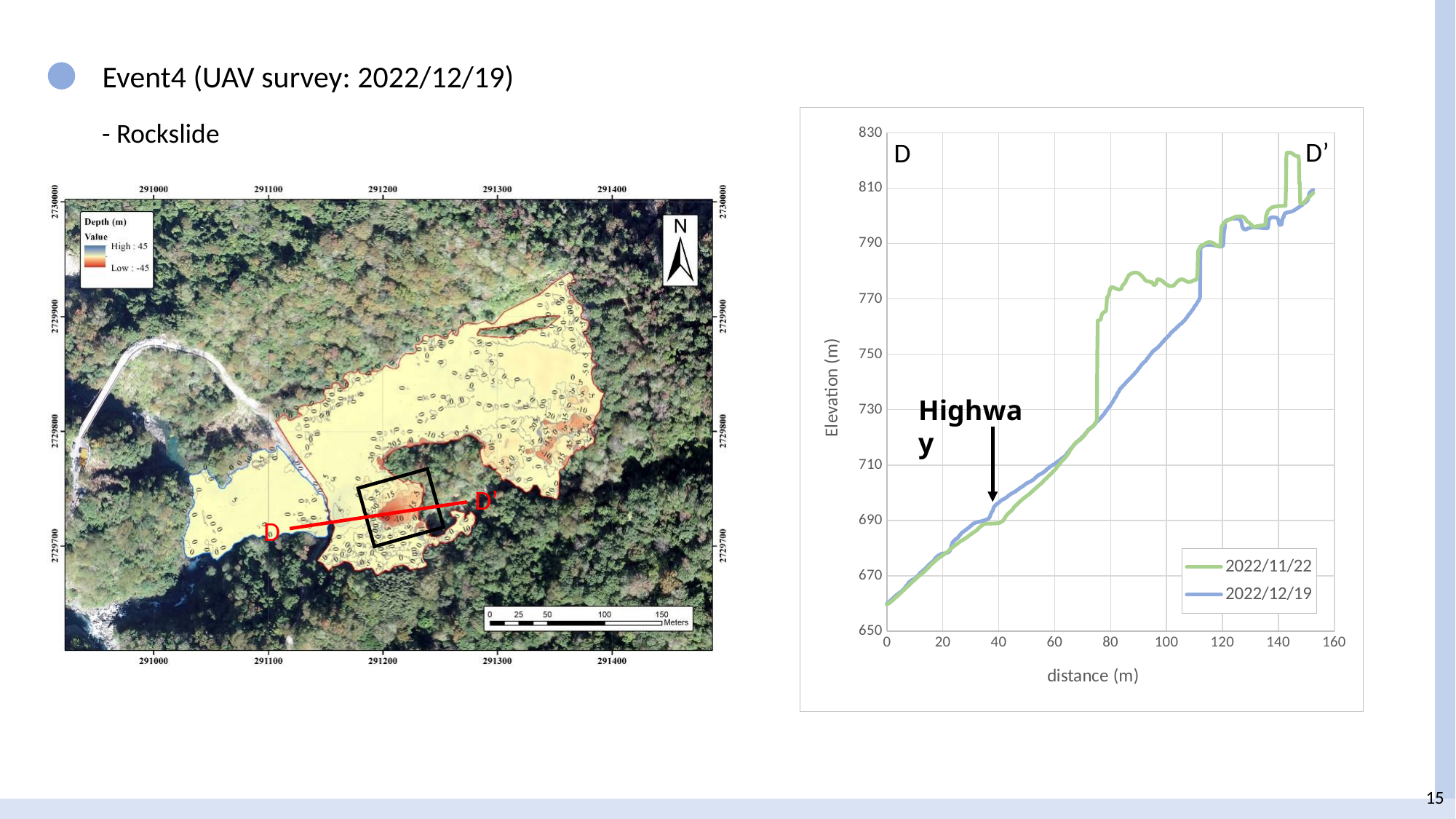
How many series does the legend of the elevation chart list? 2 What is the title of the y axis of the elevation chart? Elevation (m) In the elevation chart, which series has the higher elevation at a distance of 80 m, 2022/11/22 or 2022/12/19? 2022/11/22 In the elevation chart, is the 2022/11/22 elevation at a distance of 80 m greater or less than 750? greater What kind of chart is shown on the right side of the slide? line chart In the elevation chart, is the elevation at a distance of 0 m greater or less than 670? less In the elevation chart, is the 2022/12/19 elevation at a distance of 80 m greater or less than 750? less In the elevation chart, do the elevation values rise or fall as distance increases from D to D'? rise What is the title of the x axis of the elevation chart? distance (m) In the elevation chart, which series has the higher elevation at a distance of 100 m, 2022/11/22 or 2022/12/19? 2022/11/22